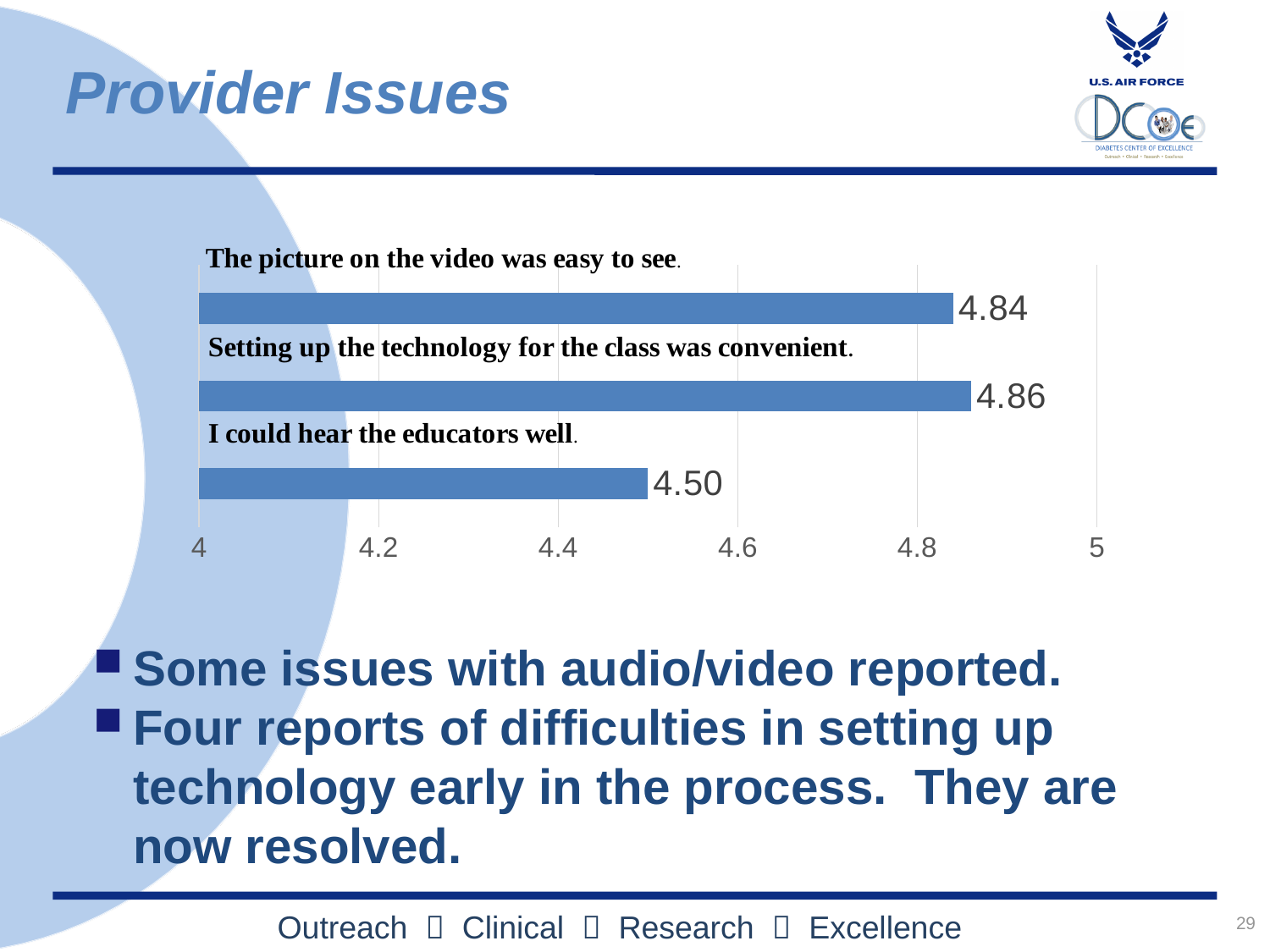
Which is larger: the value for "The picture on the video was easy to see" or the value for "I could hear the educators well"? The picture on the video was easy to see What is the maximum value shown on the horizontal axis? 5 What is the value for "I could hear the educators well"? 4.50 Which statement has the lowest value? I could hear the educators well What is the value for "Setting up the technology for the class was convenient"? 4.86 What kind of chart is shown on the slide? Bar chart What is the value for "The picture on the video was easy to see"? 4.84 Is the value for "I could hear the educators well" greater or less than 4.6? less What is the difference between the values for "Setting up the technology for the class was convenient" and "I could hear the educators well"? 0.36 What is the difference between the values for "The picture on the video was easy to see" and "I could hear the educators well"? 0.34 Is the value for "Setting up the technology for the class was convenient" greater or less than 4.8? greater How many statements are plotted in the chart? 3